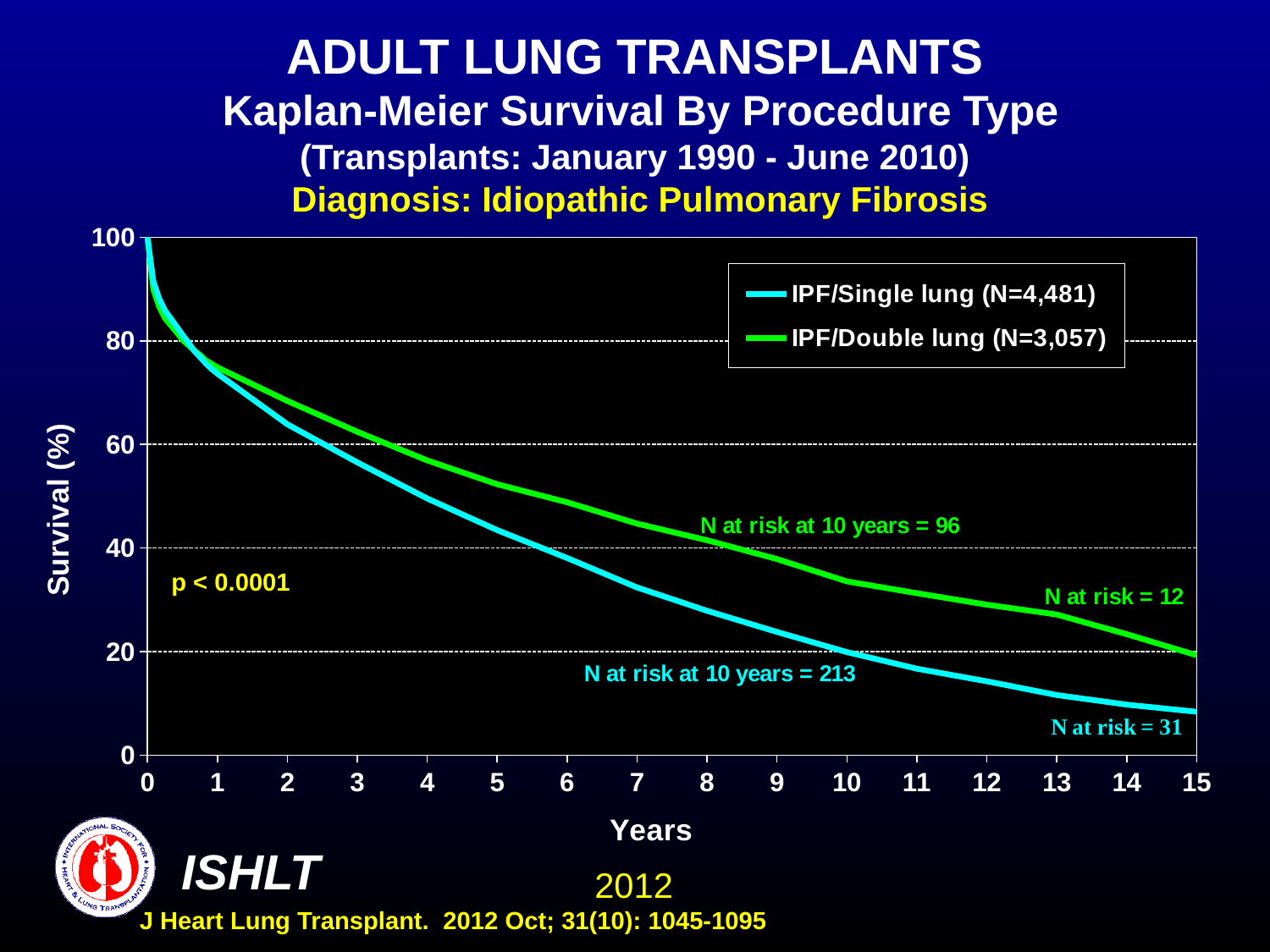
Is the survival for IPF/Double lung at 10 years greater or less than 20%? greater What is the N at risk at 10 years for the IPF/Single lung group? 213 What is the sample size (N) for the IPF/Single lung group shown in the legend? 4,481 What kind of chart is shown on the slide? line chart What is the sample size (N) for the IPF/Double lung group shown in the legend? 3,057 What is the N at risk at the end of follow-up for the IPF/Double lung group? 12 Is the survival for IPF/Single lung at 15 years greater or less than 20%? less What is the N at risk at the end of follow-up for the IPF/Single lung group? 31 What is the N at risk at 10 years for the IPF/Double lung group? 96 Do the survival curves rise or fall as years increase? fall How many series does the legend list? 2 At 10 years, which group has the higher survival, IPF/Single lung or IPF/Double lung? IPF/Double lung